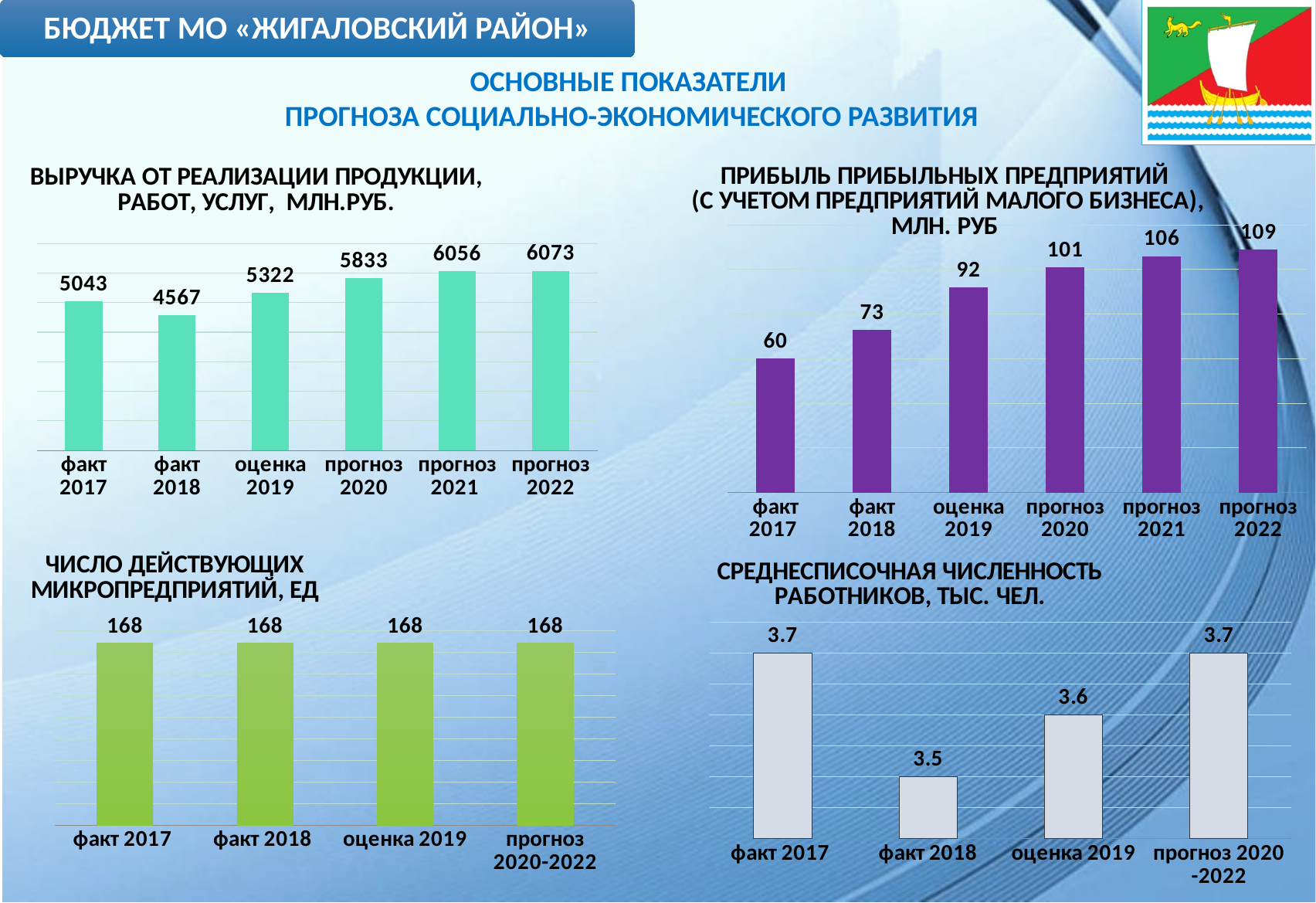
In the chart 'ПРИБЫЛЬ ПРИБЫЛЬНЫХ ПРЕДПРИЯТИЙ (С УЧЕТОМ ПРЕДПРИЯТИЙ МАЛОГО БИЗНЕСА), МЛН. РУБ' (top right), which category has the lowest value? факт 2017 In the chart 'ПРИБЫЛЬ ПРИБЫЛЬНЫХ ПРЕДПРИЯТИЙ (С УЧЕТОМ ПРЕДПРИЯТИЙ МАЛОГО БИЗНЕСА), МЛН. РУБ' (top right), what is the difference between прогноз 2022 and факт 2017? 49 In the chart 'СРЕДНЕСПИСОЧНАЯ ЧИСЛЕННОСТЬ РАБОТНИКОВ, ТЫС. ЧЕЛ.' (bottom right), which is larger, оценка 2019 or факт 2018? оценка 2019 In the chart 'ЧИСЛО ДЕЙСТВУЮЩИХ МИКРОПРЕДПРИЯТИЙ, ЕД' (bottom left), what is the value for оценка 2019? 168 In the chart 'ВЫРУЧКА ОТ РЕАЛИЗАЦИИ ПРОДУКЦИИ, РАБОТ, УСЛУГ, МЛН.РУБ.' (top left), what is the value for факт 2018? 4567 In the chart 'ПРИБЫЛЬ ПРИБЫЛЬНЫХ ПРЕДПРИЯТИЙ (С УЧЕТОМ ПРЕДПРИЯТИЙ МАЛОГО БИЗНЕСА), МЛН. РУБ' (top right), do the values rise or fall from факт 2017 to прогноз 2022? rise In the chart 'ВЫРУЧКА ОТ РЕАЛИЗАЦИИ ПРОДУКЦИИ, РАБОТ, УСЛУГ, МЛН.РУБ.' (top left), which category has the highest value? прогноз 2022 In the chart 'ПРИБЫЛЬ ПРИБЫЛЬНЫХ ПРЕДПРИЯТИЙ (С УЧЕТОМ ПРЕДПРИЯТИЙ МАЛОГО БИЗНЕСА), МЛН. РУБ' (top right), what is the value for оценка 2019? 92 In the chart 'ВЫРУЧКА ОТ РЕАЛИЗАЦИИ ПРОДУКЦИИ, РАБОТ, УСЛУГ, МЛН.РУБ.' (top left), how many bars are plotted? 6 In the chart 'СРЕДНЕСПИСОЧНАЯ ЧИСЛЕННОСТЬ РАБОТНИКОВ, ТЫС. ЧЕЛ.' (bottom right), what is the value for факт 2018? 3.5 In the chart 'ВЫРУЧКА ОТ РЕАЛИЗАЦИИ ПРОДУКЦИИ, РАБОТ, УСЛУГ, МЛН.РУБ.' (top left), what is the difference between прогноз 2020 and оценка 2019? 511 In the chart 'ЧИСЛО ДЕЙСТВУЮЩИХ МИКРОПРЕДПРИЯТИЙ, ЕД' (bottom left), how many categories are shown? 4